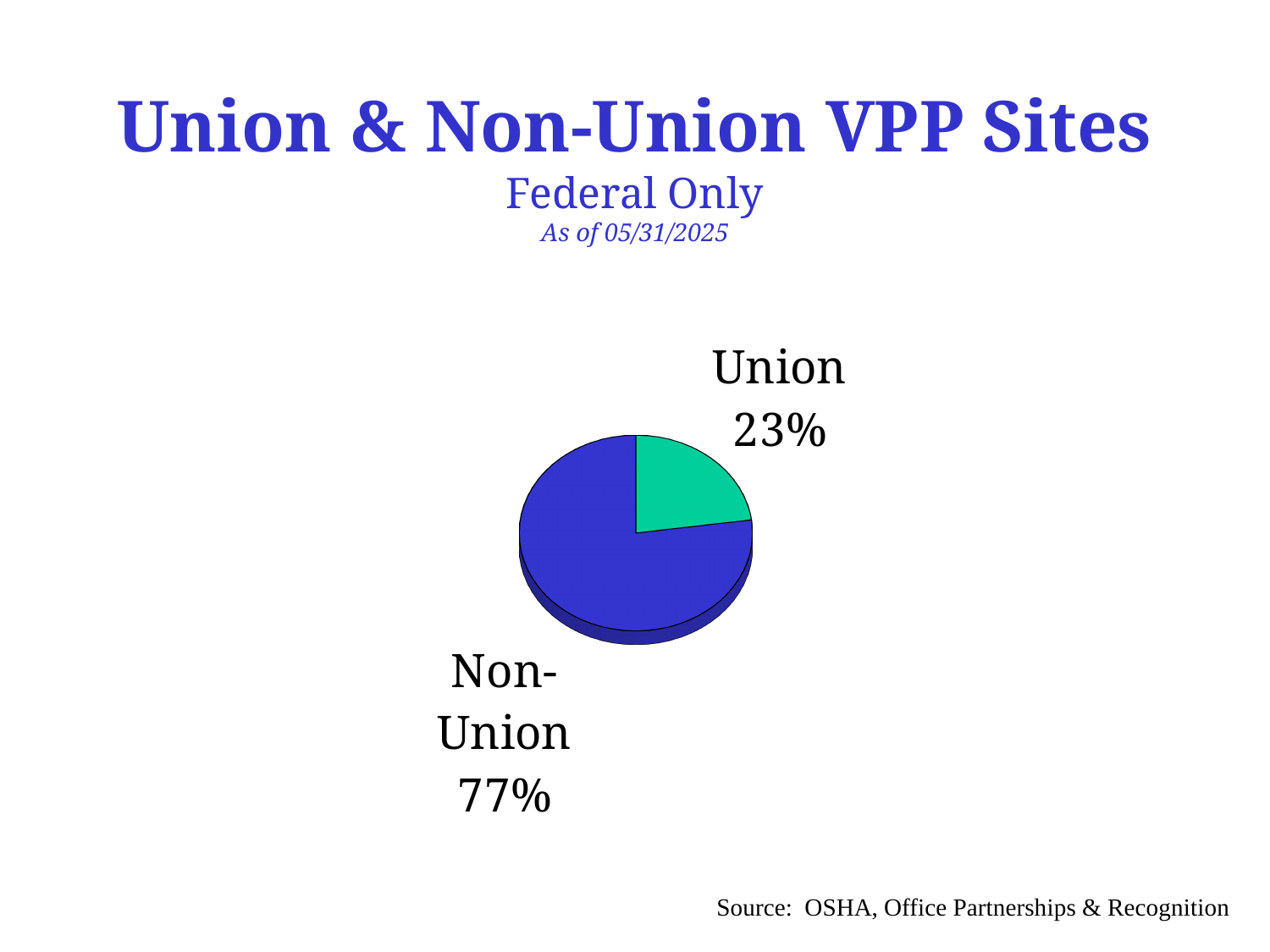
What is the difference in percentage points between the Non-Union and Union slices? 54 What colour is the Union slice of the pie? Green Which slice of the pie is the largest? Non-Union Which slice of the pie is the smallest? Union What is the title of the slide? Union & Non-Union VPP Sites What is the combined share of the Union and Non-Union slices? 100% What kind of chart is shown on the slide? Pie chart What share of the pie is labelled Non-Union? 77% How many slices does the pie chart have? 2 Which is larger, the Union slice or the Non-Union slice? Non-Union What share of the pie is labelled Union? 23%